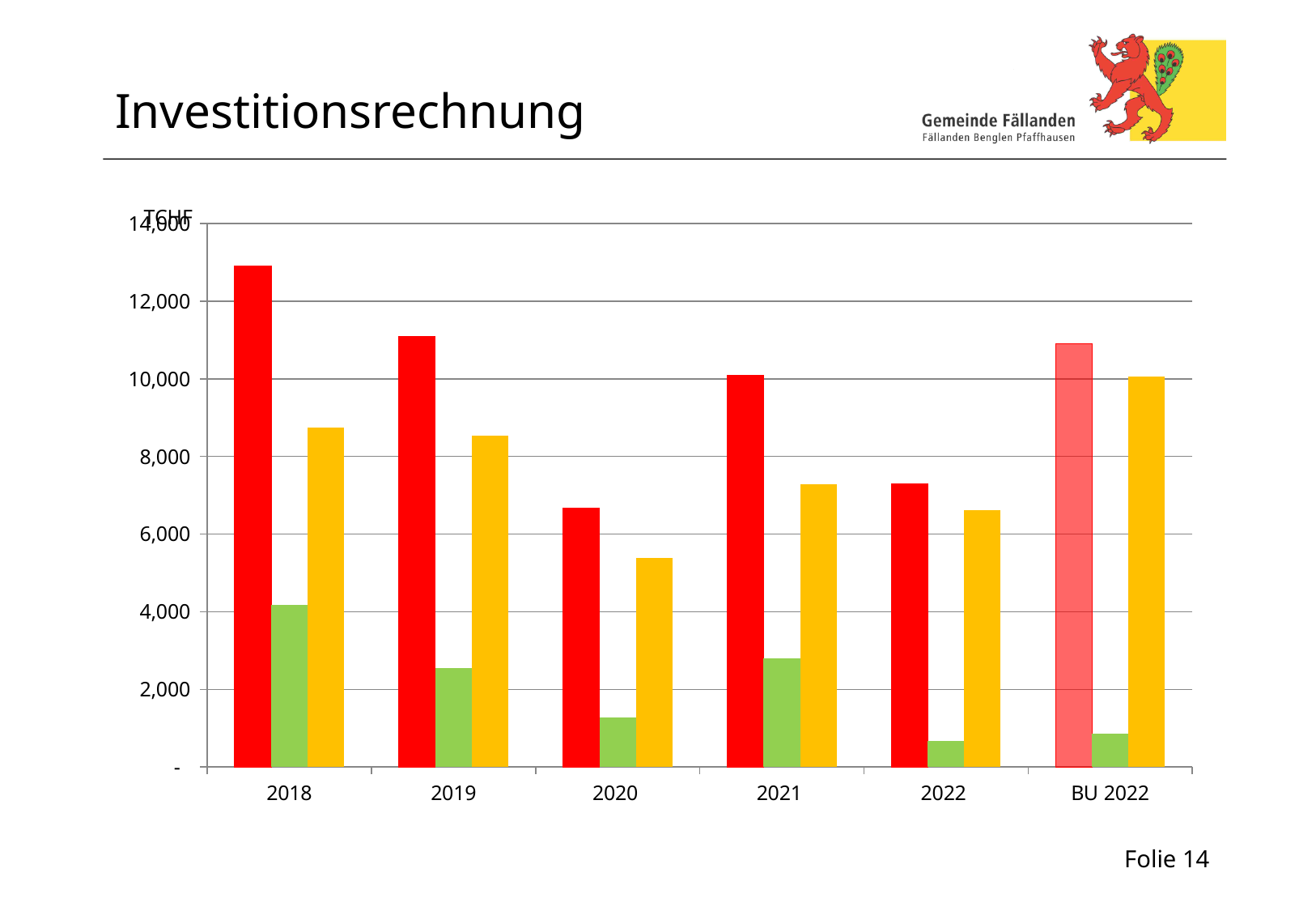
How many categories are shown on the x axis of the chart? 6 Which is larger, the red bar for 2018 or the red bar for 2019? 2018 Is the red bar for 2018 greater or less than 12,000? greater In which category is the red bar the highest? 2018 Is the yellow bar for 2020 greater or less than 6,000? less What kind of chart is shown on the slide? bar chart Do the red bars rise or fall from 2018 to 2020? fall What unit label is shown at the top of the vertical axis? TCHF Is the red bar for 2022 greater or less than 8,000? less In which category is the green bar the lowest? 2022 What is the title of the chart slide? Investitionsrechnung